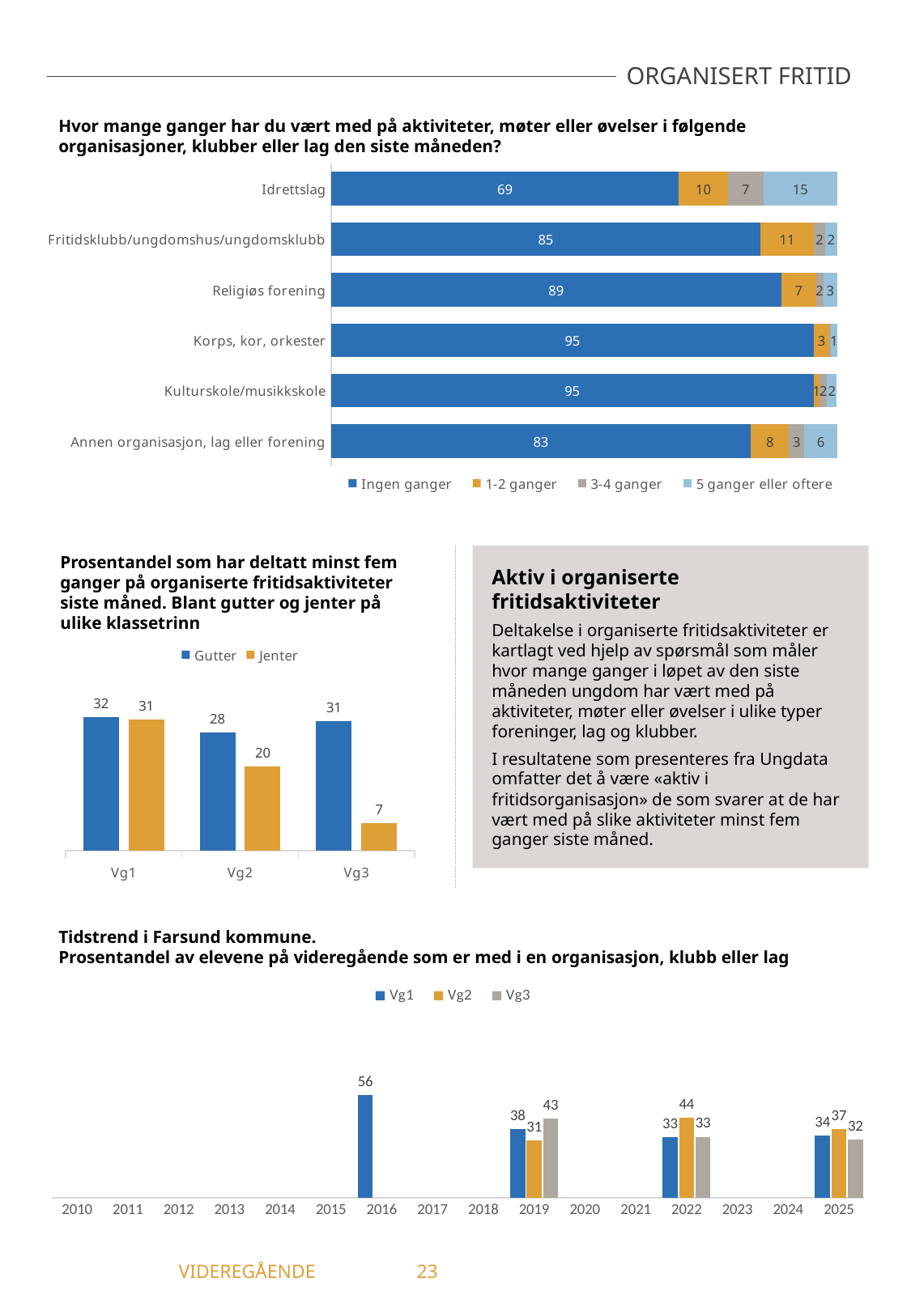
In the chart 'Prosentandel som har deltatt minst fem ganger...', what is the value for Jenter at Vg3? 7 What kind of chart is the 'Tidstrend i Farsund kommune' chart? Bar chart In the chart 'Prosentandel som har deltatt minst fem ganger...', what is the difference between Gutter and Jenter at Vg3? 24 In the top chart about participation in organisations, what percentage answered 'Ingen ganger' for Idrettslag? 69 In the top chart about participation in organisations, how many categories (organisation types) are shown? 6 In the top chart about participation in organisations, which category has the lowest 'Ingen ganger' value? Idrettslag In the top chart about participation in organisations, how many series does the legend list? 4 In the chart 'Tidstrend i Farsund kommune', what is the value for Vg1 in 2016? 56 In the chart 'Tidstrend i Farsund kommune', which series has the highest value in 2022? Vg2 In the top chart about participation in organisations, what is the value for '5 ganger eller oftere' for Idrettslag? 15 In the chart 'Prosentandel som har deltatt minst fem ganger...', which is larger at Vg2: Gutter or Jenter? Gutter In the top chart about participation in organisations, what is the difference between the 'Ingen ganger' values for Religiøs forening and Idrettslag? 20